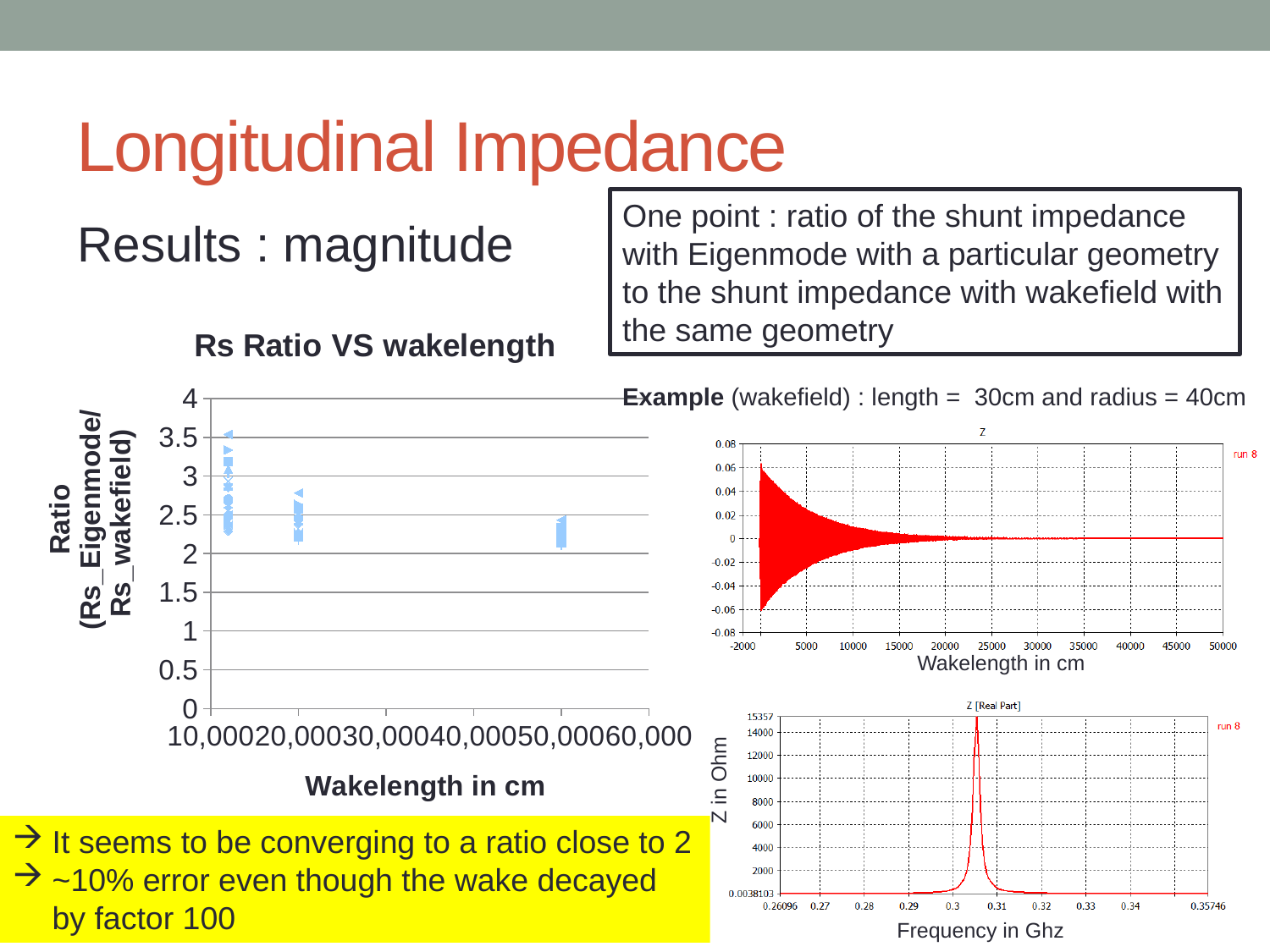
In the 'Rs Ratio VS wakelength' chart, what is the highest value shown on the y axis? 4 In the 'Rs Ratio VS wakelength' chart, how many distinct wakelength positions have data points plotted? 3 In the 'Rs Ratio VS wakelength' chart, what is the label of the x axis? Wakelength in cm What is the title of the chart at the top right of the slide? Z In the 'Rs Ratio VS wakelength' chart, are the ratio values at a wakelength of about 10,000 cm greater or less than 2? greater What kind of chart is the 'Rs Ratio VS wakelength' chart on the left? scatter chart In the bottom-right 'Z [Real Part]' chart, is the peak value of Z greater or less than 12000? greater In the top-right 'Z' chart, what series name does the legend show? run 8 In the top-right 'Z' chart, does the amplitude of the oscillation grow or decay as the wakelength increases? decay In the 'Rs Ratio VS wakelength' chart, do the ratio values rise or fall as the wakelength increases? fall In the 'Rs Ratio VS wakelength' chart, are the ratio values at a wakelength of about 50,000 cm greater or less than 2.5? less